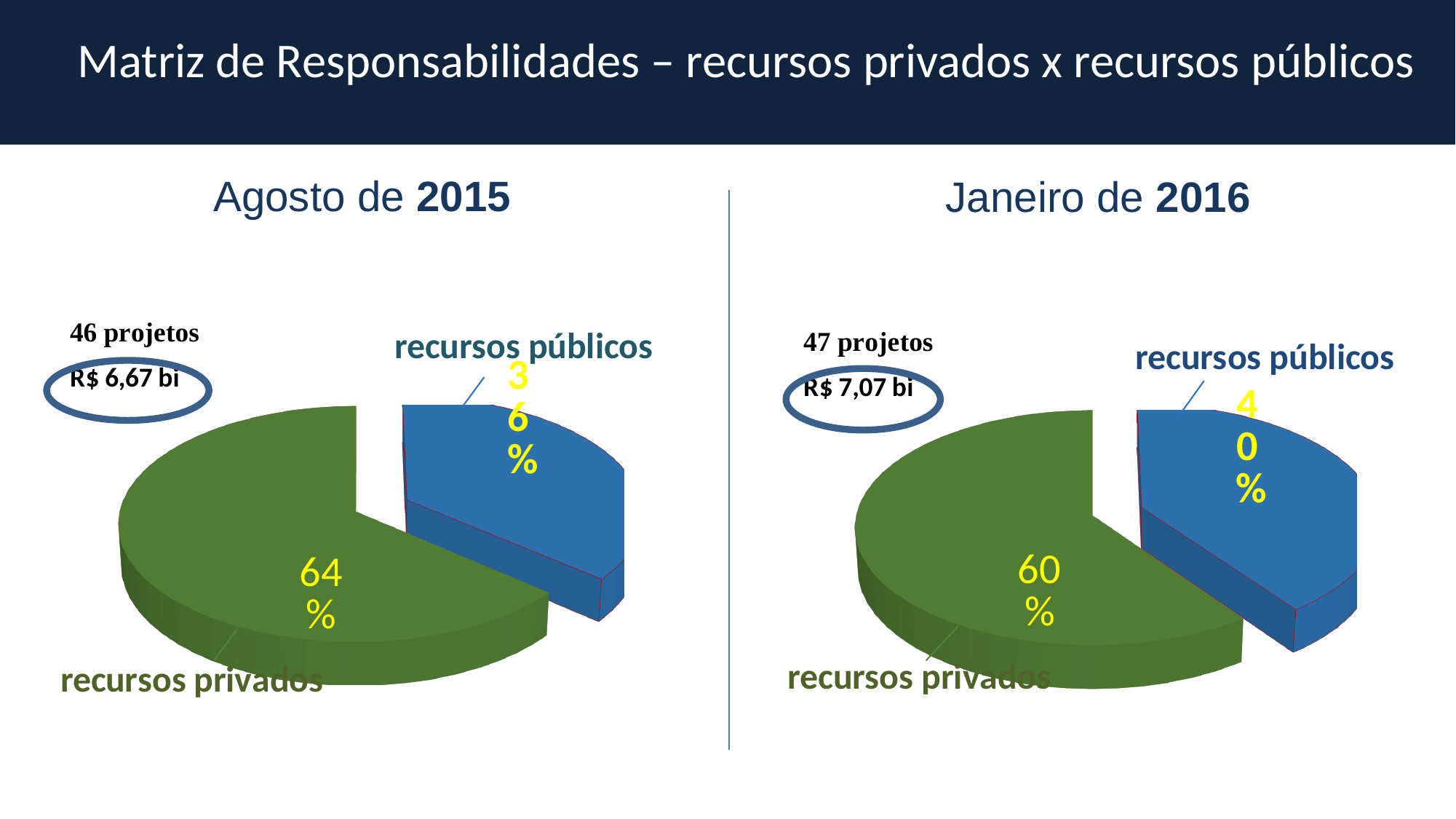
How many slices does the Janeiro de 2016 pie chart have? 2 In the Janeiro de 2016 chart, what share is labelled for recursos públicos? 40% In the Janeiro de 2016 chart, what share is labelled for recursos privados? 60% In the Janeiro de 2016 chart, what is the difference in percentage points between recursos privados and recursos públicos? 20 In the Agosto de 2015 chart, what share is labelled for recursos públicos? 36% Which chart shows a larger share for recursos públicos, Agosto de 2015 or Janeiro de 2016? Janeiro de 2016 In the Janeiro de 2016 chart, which slice is the smallest? recursos públicos In the Agosto de 2015 chart, what share is labelled for recursos privados? 64% In the Janeiro de 2016 chart, what colour is the recursos públicos slice? blue In the Agosto de 2015 chart, which slice is the largest? recursos privados What kind of chart is used on the left side of the slide (Agosto de 2015)? pie chart In the Agosto de 2015 chart, what is the difference in percentage points between recursos privados and recursos públicos? 28